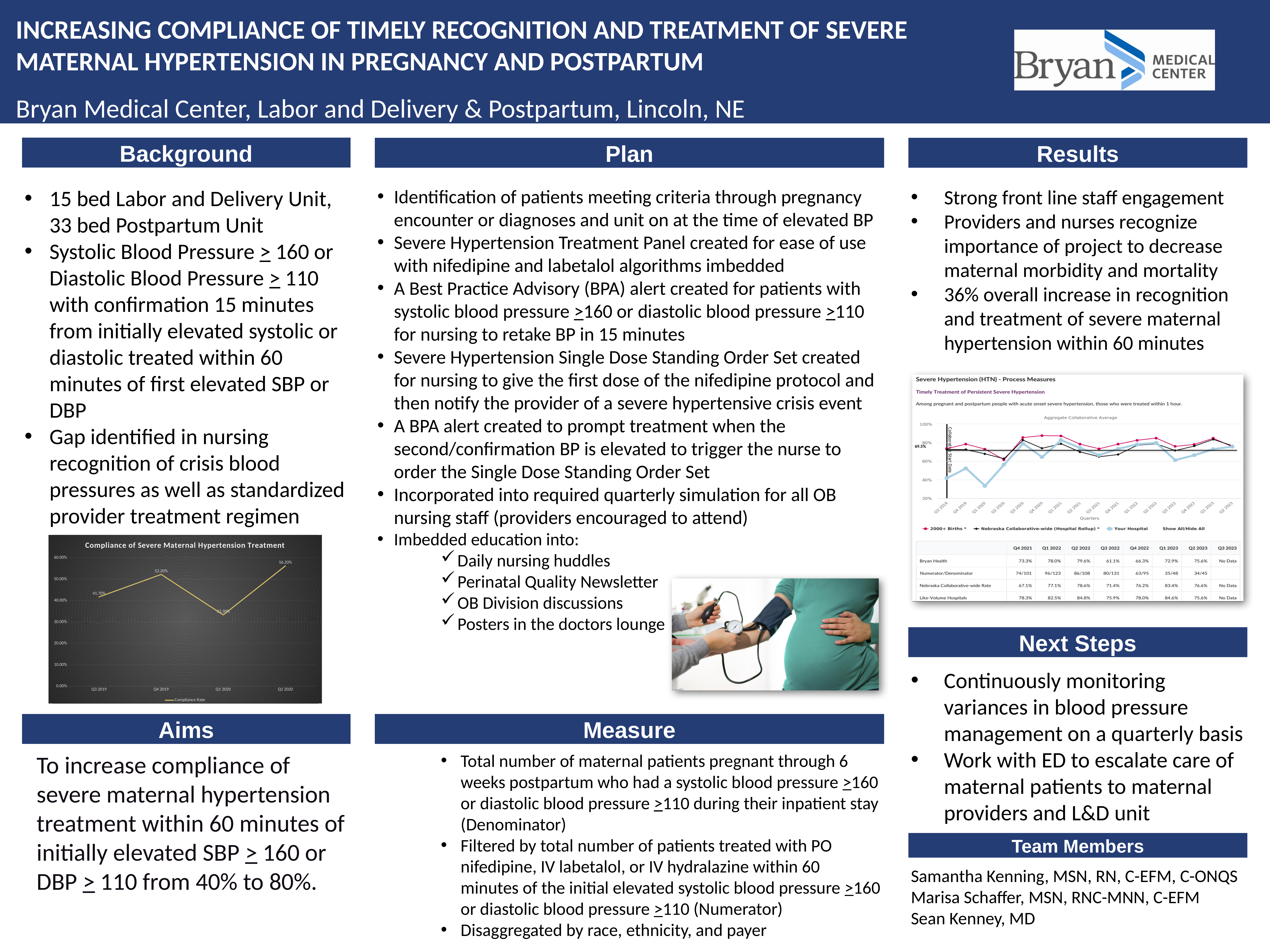
What kind of chart is the 'Compliance of Severe Maternal Hypertension Treatment' chart? Line chart On the 'Compliance of Severe Maternal Hypertension Treatment' chart, which quarter has the lowest compliance rate? Q1 2020 On the 'Compliance of Severe Maternal Hypertension Treatment' chart, which quarter has the highest compliance rate? Q2 2020 On the 'Compliance of Severe Maternal Hypertension Treatment' chart, what is the compliance rate for Q4 2019? 52.20% On the 'Severe Hypertension (HTN) - Process Measures' chart in the Results section, how many data series does the legend list? 3 On the 'Compliance of Severe Maternal Hypertension Treatment' chart, how many quarters are plotted on the x axis? 4 On the 'Compliance of Severe Maternal Hypertension Treatment' chart, is the compliance rate for Q1 2020 greater or less than 40.00%? less On the 'Compliance of Severe Maternal Hypertension Treatment' chart, what is the name of the series shown in the legend? Compliance Rate What kind of chart is the 'Severe Hypertension (HTN) - Process Measures' chart in the Results section? Line chart On the 'Compliance of Severe Maternal Hypertension Treatment' chart, what is the compliance rate for Q3 2019? 41.70% On the 'Compliance of Severe Maternal Hypertension Treatment' chart, what is the difference between the Q2 2020 and Q3 2019 compliance rates? 14.50% On the 'Compliance of Severe Maternal Hypertension Treatment' chart, what is the compliance rate for Q2 2020? 56.20%